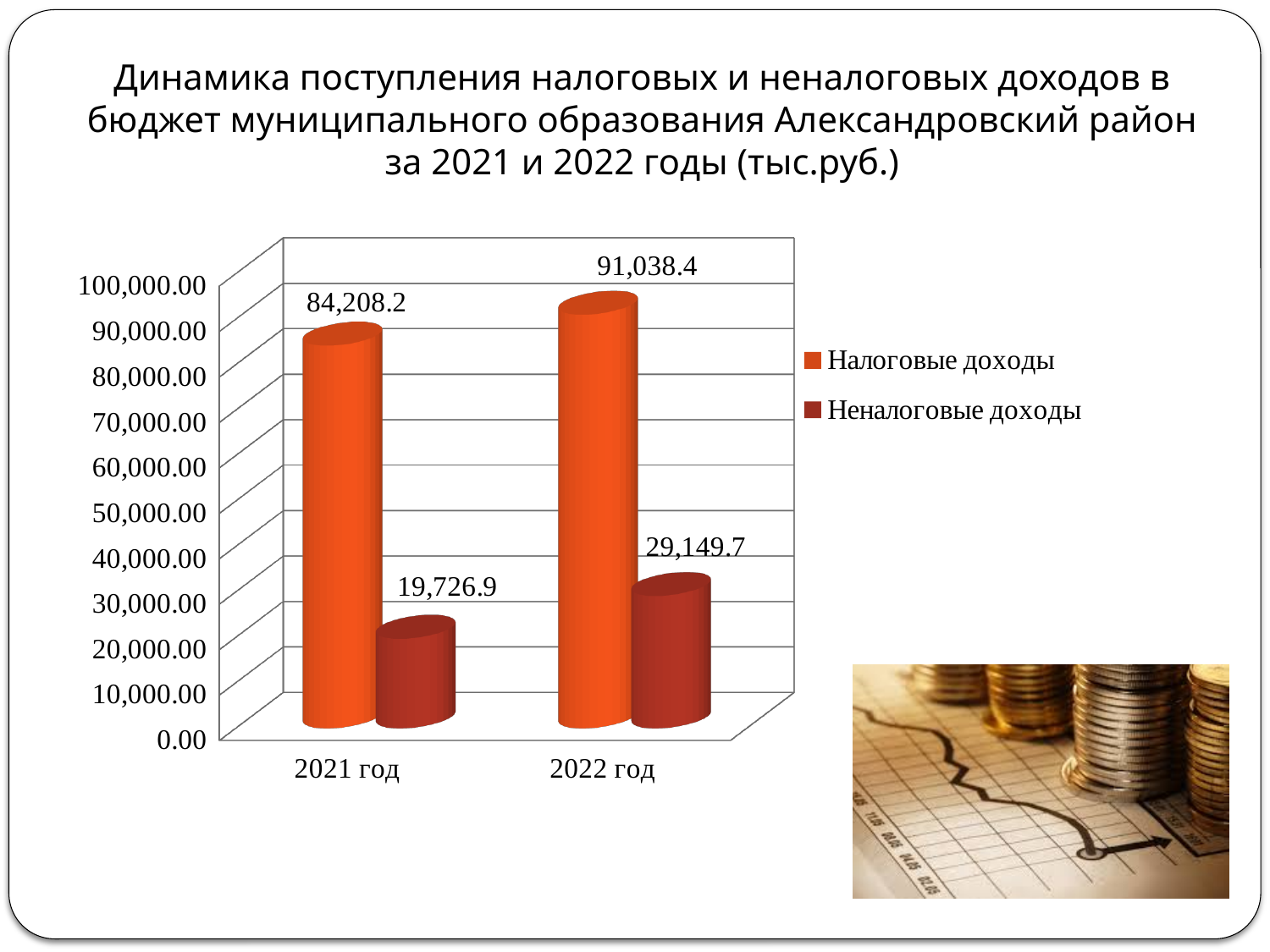
Which year has the higher value for Налоговые доходы? 2022 год What is the value of Налоговые доходы for 2022 год? 91,038.4 Do the values for Неналоговые доходы rise or fall from 2021 год to 2022 год? Rise How many series does the legend list? 2 What kind of chart is shown on the slide? Bar chart What is the value of Налоговые доходы for 2021 год? 84,208.2 What is the value of Неналоговые доходы for 2022 год? 29,149.7 By how much did Налоговые доходы increase from 2021 год to 2022 год? 6,830.2 Which year has the lower value for Неналоговые доходы? 2021 год In 2022 год, which is larger: Налоговые доходы or Неналоговые доходы? Налоговые доходы What is the value of Неналоговые доходы for 2021 год? 19,726.9 What is the difference between Неналоговые доходы in 2022 год and 2021 год? 9,422.8